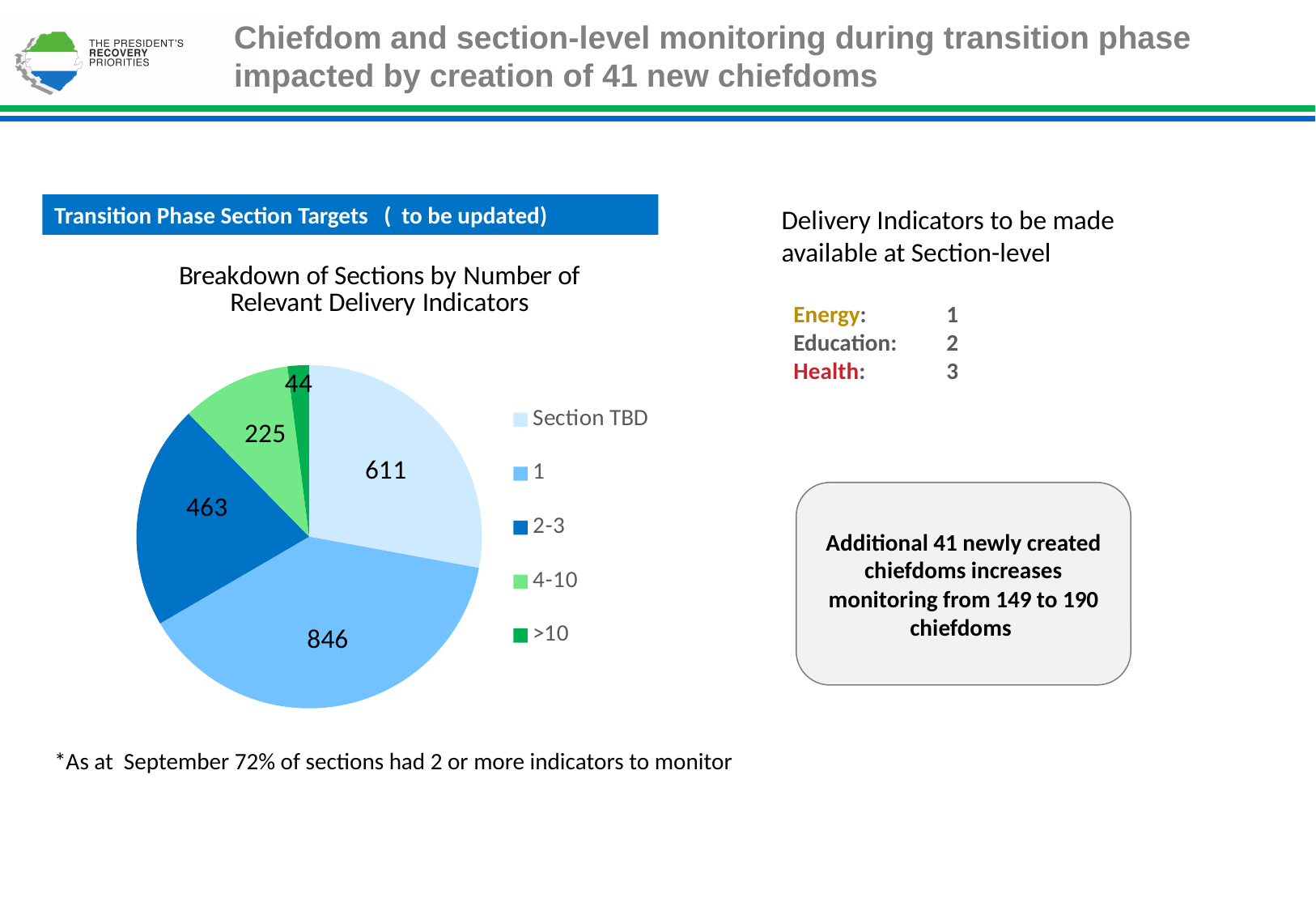
Which category has the largest slice? 1 Which category has the smallest slice? >10 Which is larger, the '4-10' slice or the 'Section TBD' slice? Section TBD What is the difference between the '1' slice and the '2-3' slice? 383 How many slices does the pie chart have? 5 What type of chart is shown on the slide? pie chart How many sections have 1 relevant delivery indicator? 846 What is the value for the '2-3' slice? 463 What is the total of all slices in the pie chart? 2189 What is the chart's title? Breakdown of Sections by Number of Relevant Delivery Indicators What is the value for the '>10' slice? 44 What is the value for the 'Section TBD' slice? 611